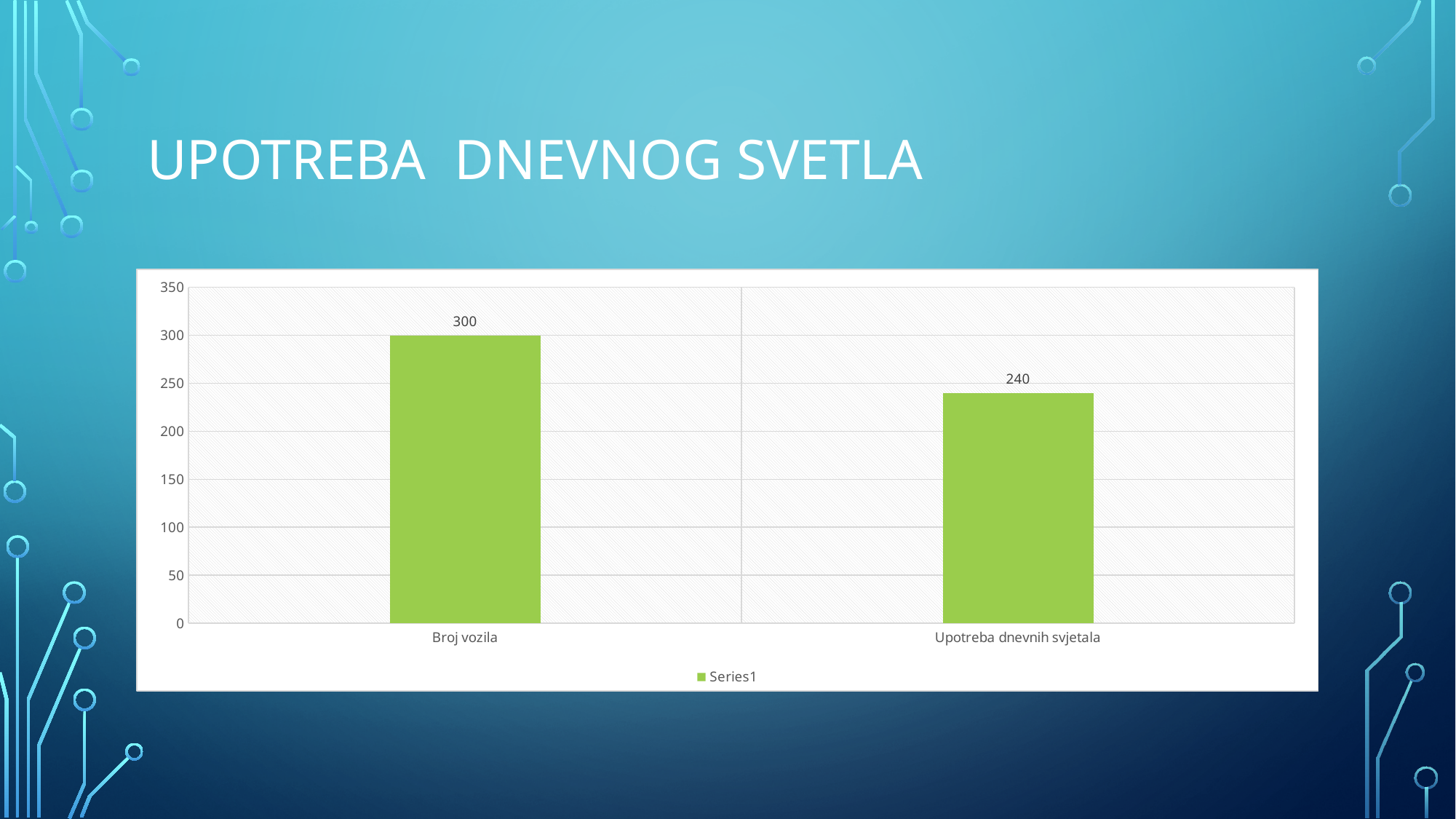
How many series does the legend list? 1 Is the value for Upotreba dnevnih svjetala greater or less than 250? less Which is larger, the value for Broj vozila or the value for Upotreba dnevnih svjetala? Broj vozila Which category has the lowest value? Upotreba dnevnih svjetala How many categories are shown on the x axis? 2 What is the difference between the values for Broj vozila and Upotreba dnevnih svjetala? 60 What is the title of the slide? UPOTREBA DNEVNOG SVETLA What kind of chart is shown on the slide? bar chart What is the value for Broj vozila? 300 Which category has the highest value? Broj vozila What is the name of the series shown in the legend? Series1 What is the value for Upotreba dnevnih svjetala? 240